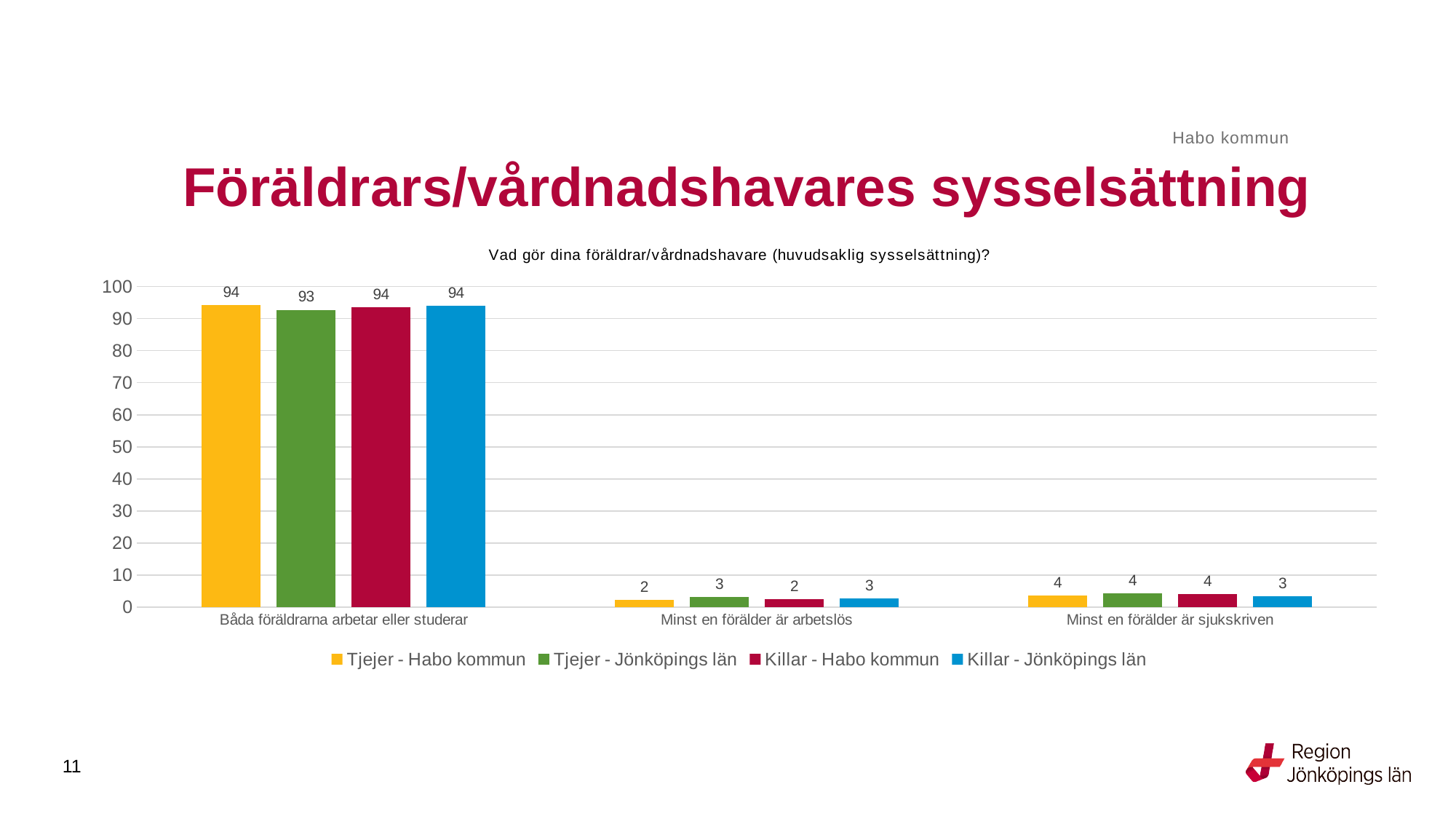
What is the value for Killar - Jönköpings län in the category 'Minst en förälder är sjukskriven'? 3 How many categories are shown on the x axis? 3 What is the value for Tjejer - Habo kommun in the category 'Minst en förälder är sjukskriven'? 4 What kind of chart is shown on the slide? Bar chart How many series does the legend list? 4 Which category has the lowest value for Tjejer - Habo kommun? Minst en förälder är arbetslös What is the value for Tjejer - Jönköpings län in the category 'Båda föräldrarna arbetar eller studerar'? 93 What is the value for Killar - Habo kommun in the category 'Minst en förälder är arbetslös'? 2 Is the value for Killar - Jönköpings län in 'Båda föräldrarna arbetar eller studerar' greater or less than 90? greater Which category has the highest values across all series? Båda föräldrarna arbetar eller studerar What is the difference between the Tjejer - Habo kommun value and the Tjejer - Jönköpings län value in the category 'Båda föräldrarna arbetar eller studerar'? 1 In the category 'Minst en förälder är arbetslös', which is larger: the value for Tjejer - Habo kommun or the value for Tjejer - Jönköpings län? Tjejer - Jönköpings län